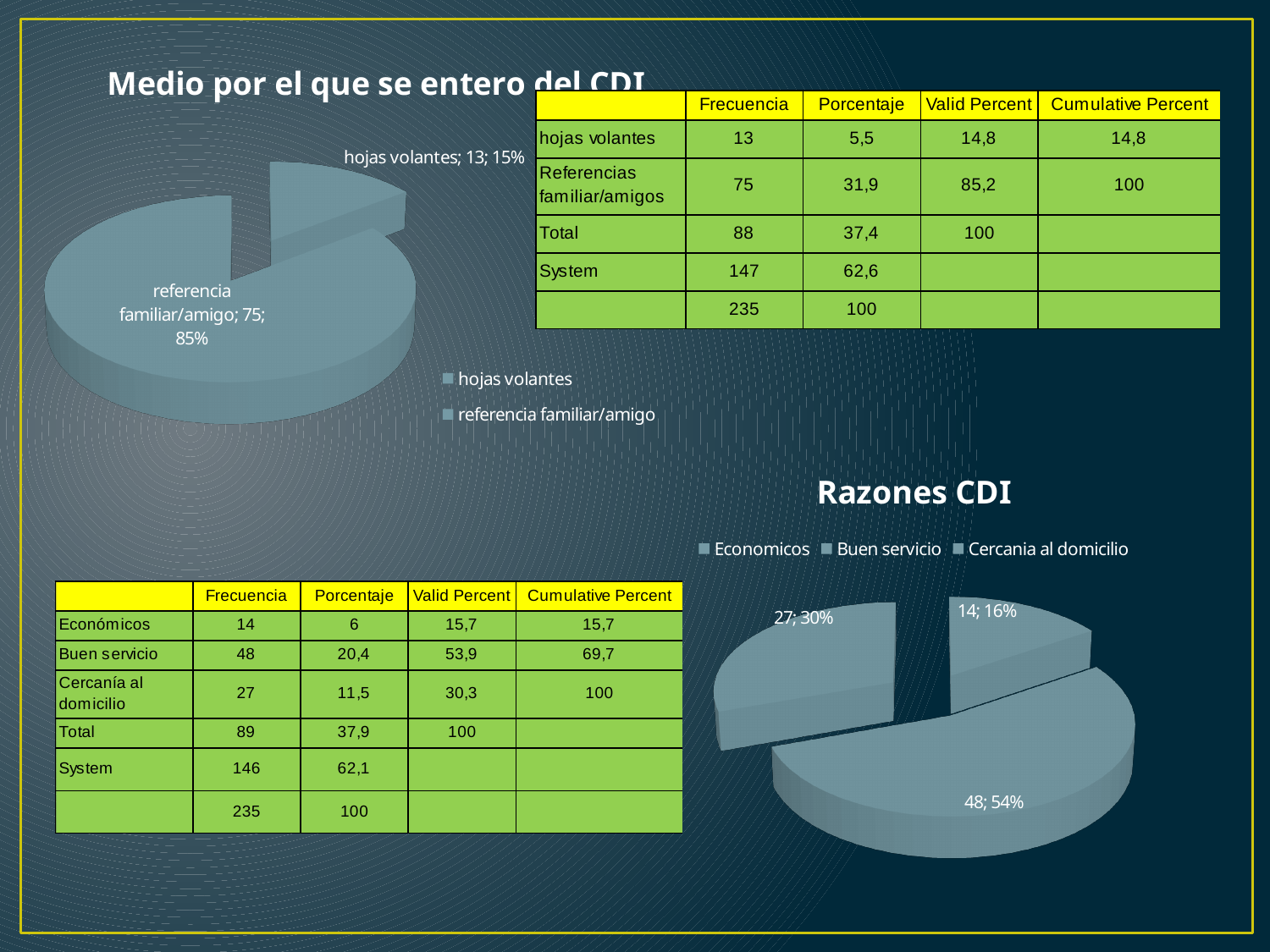
In the 'Medio por el que se entero del CDI' chart, which category has the largest slice? referencia familiar/amigo In the 'Razones CDI' chart, is the slice labelled 27 larger or smaller than the slice labelled 14? larger In the 'Razones CDI' chart, what percentage share is shown for the largest slice? 54% In the 'Medio por el que se entero del CDI' chart, what value is shown for hojas volantes? 13 How many entries does the legend of the 'Medio por el que se entero del CDI' chart list? 2 In the 'Razones CDI' chart, which legend category corresponds to the largest slice (48; 54%)? Buen servicio How many slices does the 'Razones CDI' pie chart have? 3 What are the three legend entries of the 'Razones CDI' chart? Economicos, Buen servicio, Cercania al domicilio In the 'Razones CDI' chart, what value is shown for the slice labelled 16%? 14 In the 'Medio por el que se entero del CDI' chart, what is the difference between the values for referencia familiar/amigo and hojas volantes? 62 In the 'Medio por el que se entero del CDI' chart, what percentage share does referencia familiar/amigo have? 85% What kind of chart is 'Medio por el que se entero del CDI'? pie chart